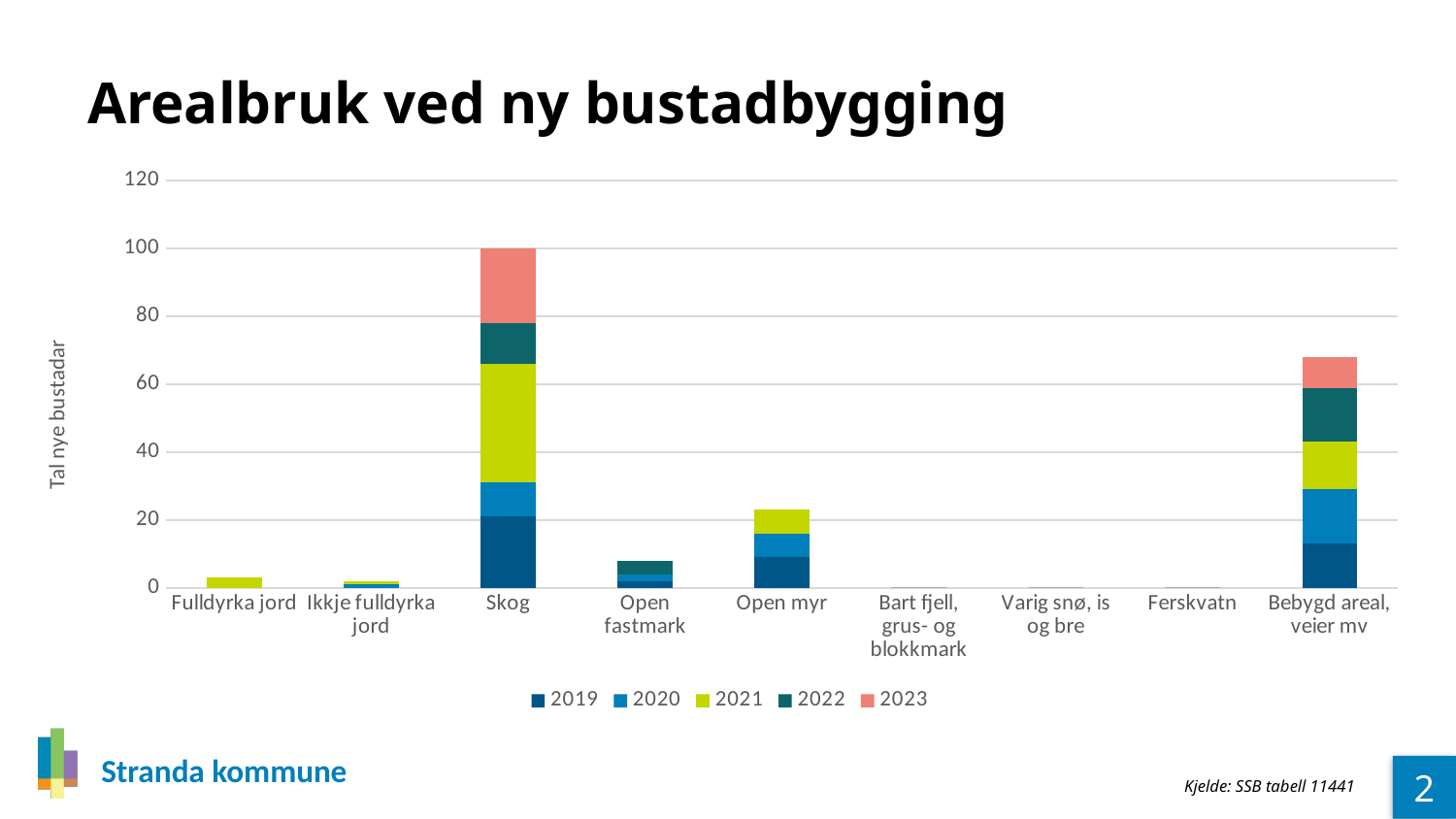
What kind of chart is shown on the slide? Stacked bar chart Is the total value for Open myr greater or less than 20? greater How many series does the legend list? 5 Is the total value for Fulldyrka jord greater or less than 20? less What is the label on the y axis? Tal nye bustadar Is the total value for Open fastmark greater or less than 20? less Which category has the highest total stacked bar? Skog Which has a larger total stacked bar, Skog or Bebygd areal, veier mv? Skog What is the title of the chart? Arealbruk ved ny bustadbygging What is the total of the stacked bar for Skog? 100 How many categories are shown on the x axis? 9